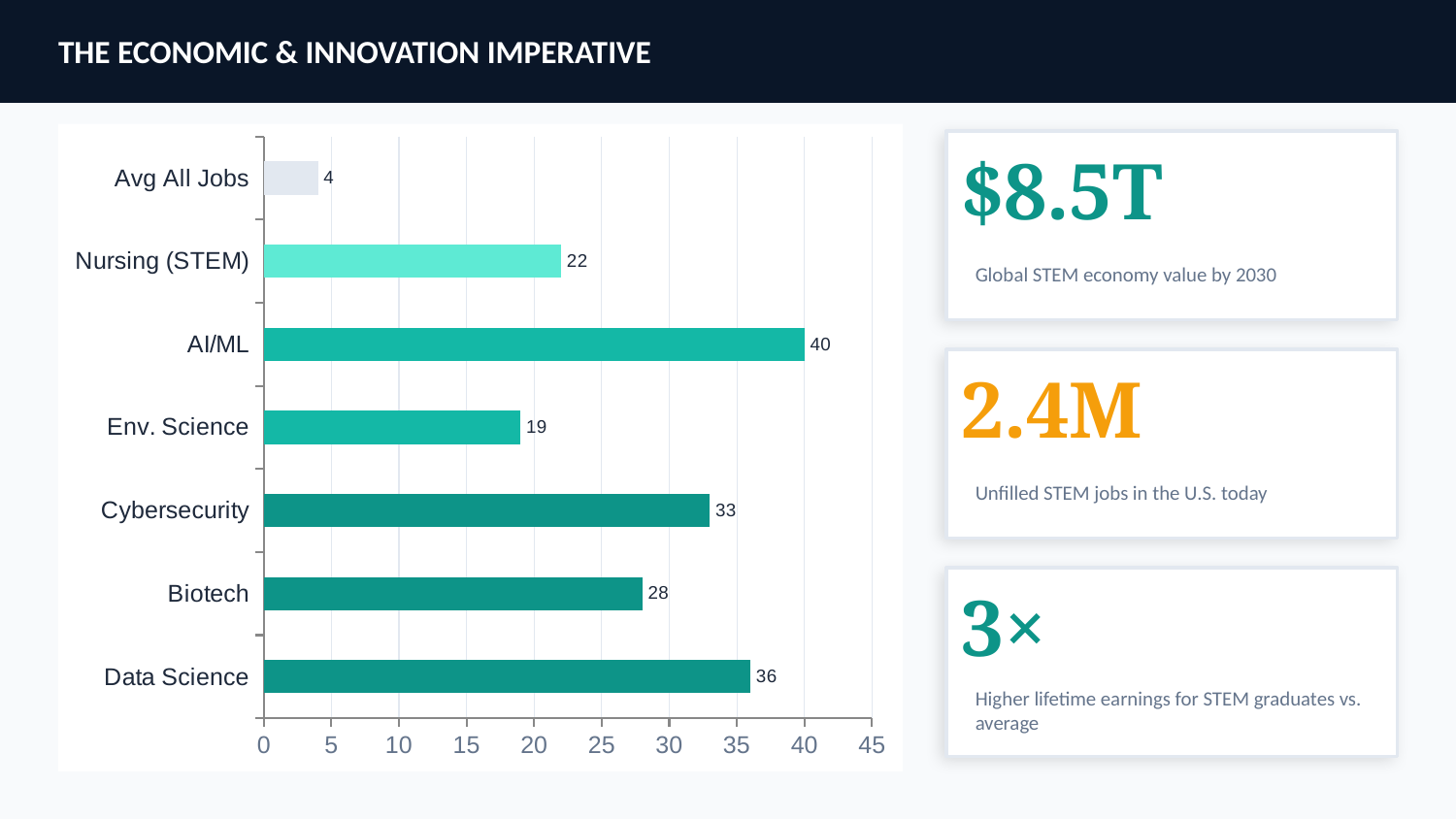
How many categories are shown in the chart? 7 Which category has the highest value? AI/ML What is the difference between the values for Data Science and Biotech? 8 What kind of chart is shown on the slide? bar chart Which is larger, the value for Cybersecurity or the value for Env. Science? Cybersecurity What is the highest value shown on the x axis? 45 What is the value for AI/ML? 40 Which category has the lowest value? Avg All Jobs What is the value for Avg All Jobs? 4 Is the value for Data Science greater or less than 35? greater What is the value for Nursing (STEM)? 22 What is the difference between the values for AI/ML and Avg All Jobs? 36